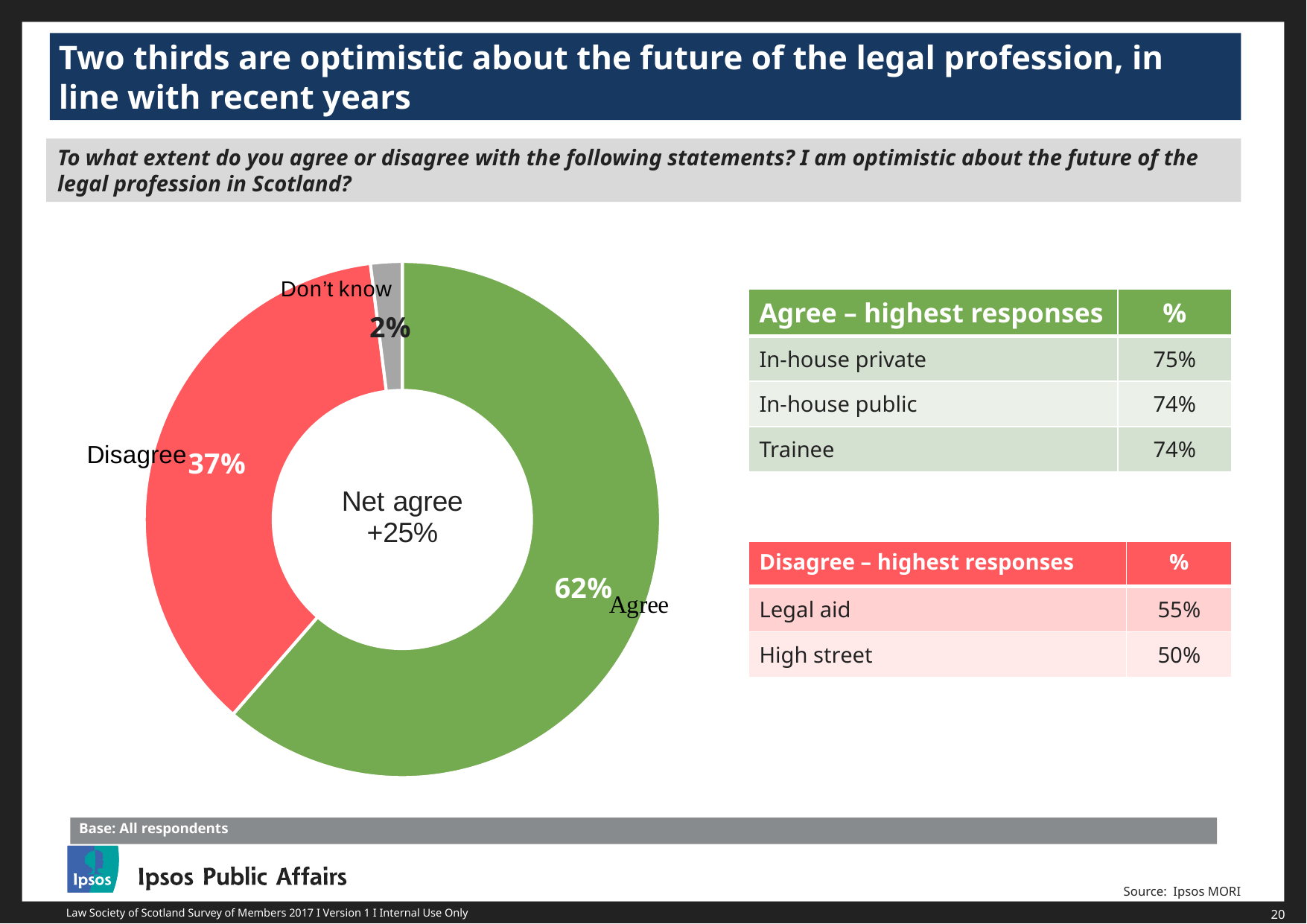
Which is larger, the share for Disagree or the share for Agree? Agree What type of chart is used to show the agree/disagree responses? Donut (pie) chart What percentage of respondents agree that they are optimistic about the future of the legal profession in Scotland? 62% Which response category has the largest share of the donut chart? Agree What percentage of respondents answered 'Don't know'? 2% Which response category has the smallest share of the donut chart? Don't know What is the difference in percentage points between Agree and Disagree? 25 What colour is the Agree segment of the donut chart? Green What net agree figure is shown in the centre of the donut chart? +25% Is the value for Disagree greater or less than 50%? less How many response categories are shown in the donut chart? 3 What percentage of respondents disagree? 37%